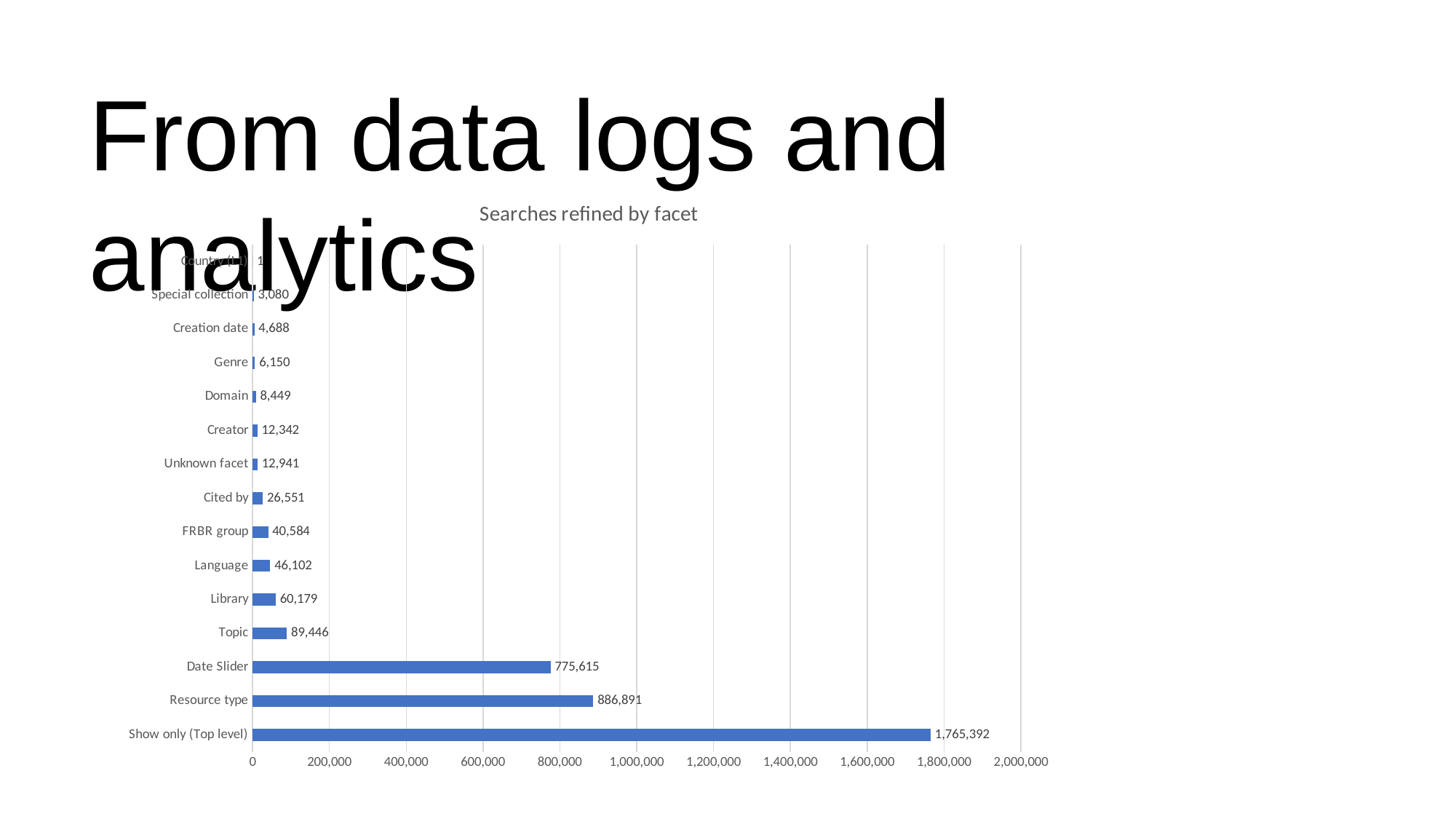
What is the value for Date Slider? 775,615 What is the title of the chart? Searches refined by facet Is the value for Resource type greater or less than 800,000? greater Is the value for Date Slider greater or less than 800,000? less What kind of chart is shown on the slide? bar chart What is the difference between the values for Show only (Top level) and Resource type? 878,501 What is the value for Show only (Top level) in the Searches refined by facet chart? 1,765,392 Which is larger, the value for Library or the value for Topic? Topic What is the difference between the values for Resource type and Date Slider? 111,276 Which facet has the highest number of searches refined? Show only (Top level) What is the value for Language? 46,102 What is the value for Topic? 89,446